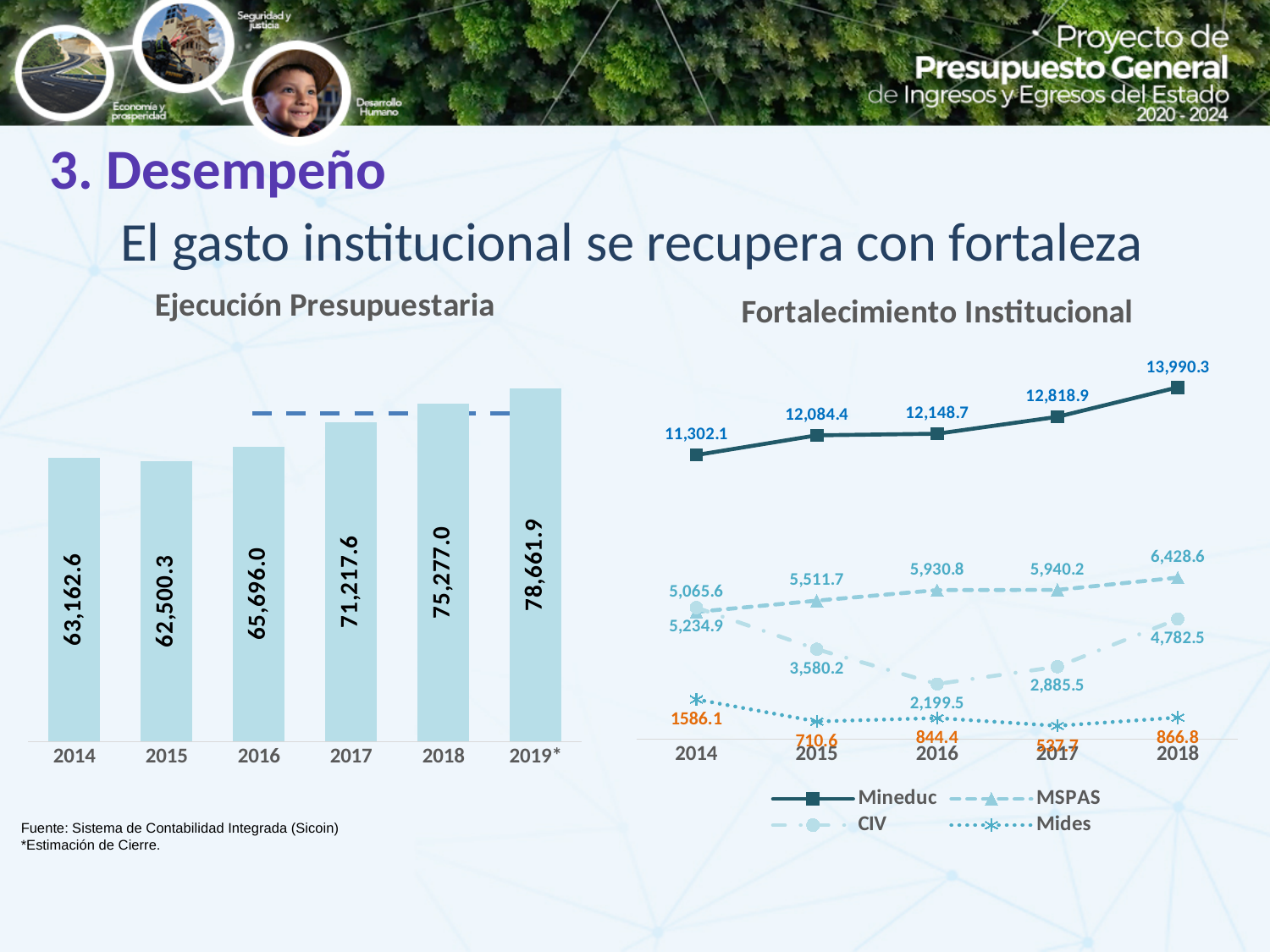
In the Ejecución Presupuestaria chart, which year has the highest value? 2019* In the Ejecución Presupuestaria chart, how many bars are shown? 6 In the Ejecución Presupuestaria chart, which year has the lowest value? 2015 What kind of chart is the Ejecución Presupuestaria chart? Bar chart In the Fortalecimiento Institucional chart, which series has the highest values across all years? Mineduc In the Fortalecimiento Institucional chart, is the MSPAS value for 2018 larger or smaller than the CIV value for 2018? Larger In the Fortalecimiento Institucional chart, what is the CIV value for 2016? 2,199.5 In the Ejecución Presupuestaria chart, what is the value for 2017? 71,217.6 In the Fortalecimiento Institucional chart, does the Mineduc series rise or fall from 2014 to 2018? Rises In the Fortalecimiento Institucional chart, what is the Mineduc value for 2018? 13,990.3 In the Ejecución Presupuestaria chart, what is the difference between the 2018 and 2017 values? 4,059.4 In the Fortalecimiento Institucional chart, how many series does the legend list? 4